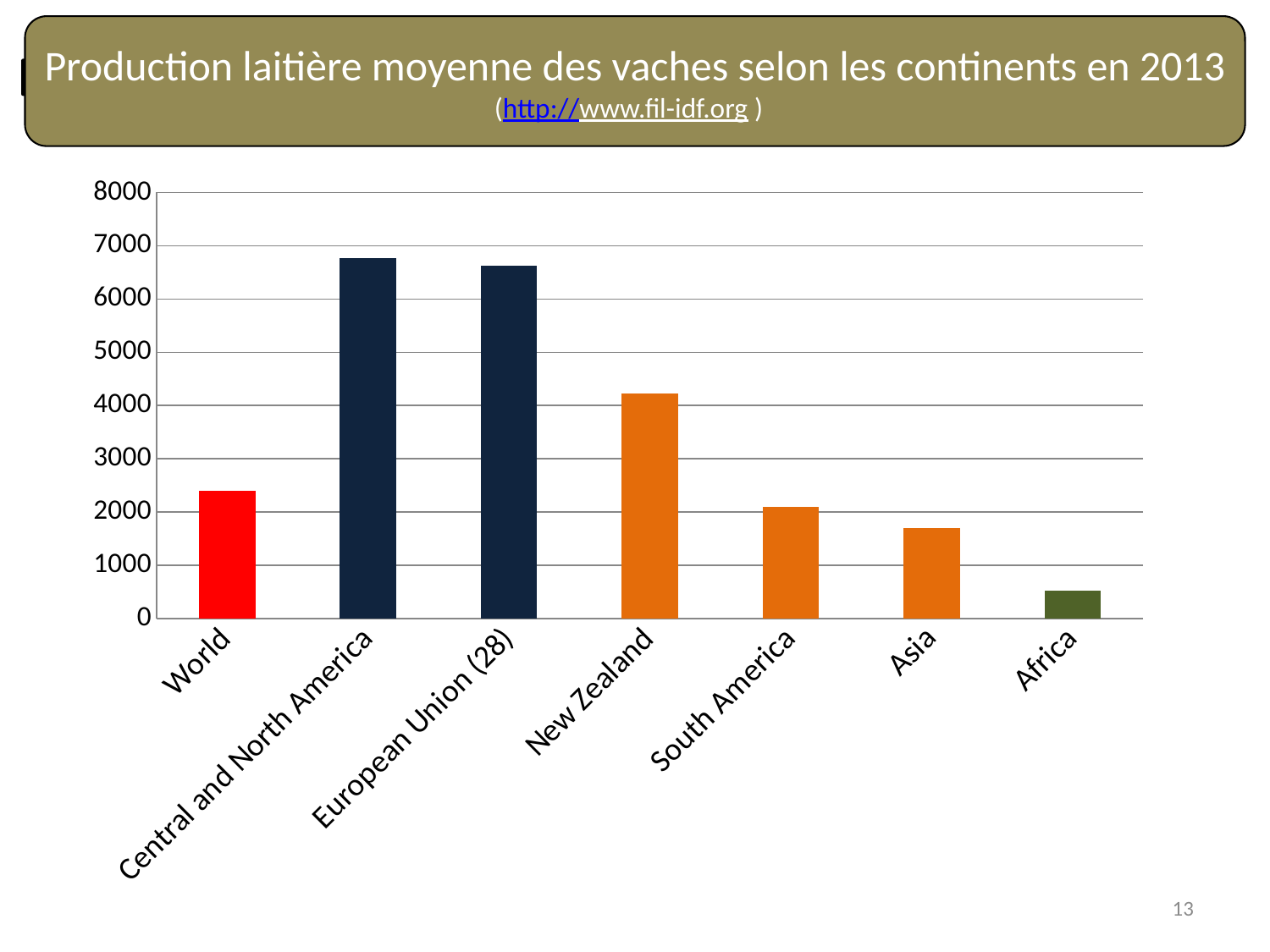
What kind of chart is shown on the slide? bar chart How many categories are shown on the x axis of the chart? 7 Is the value for World greater or less than 2000? greater Which has a larger value, New Zealand or South America? New Zealand Is the value for Africa greater or less than 1000? less Is the value for European Union (28) greater or less than 6000? greater Which category has the lowest value in the chart? Africa What colour is the bar for World? red Which has a larger value, World or Asia? World